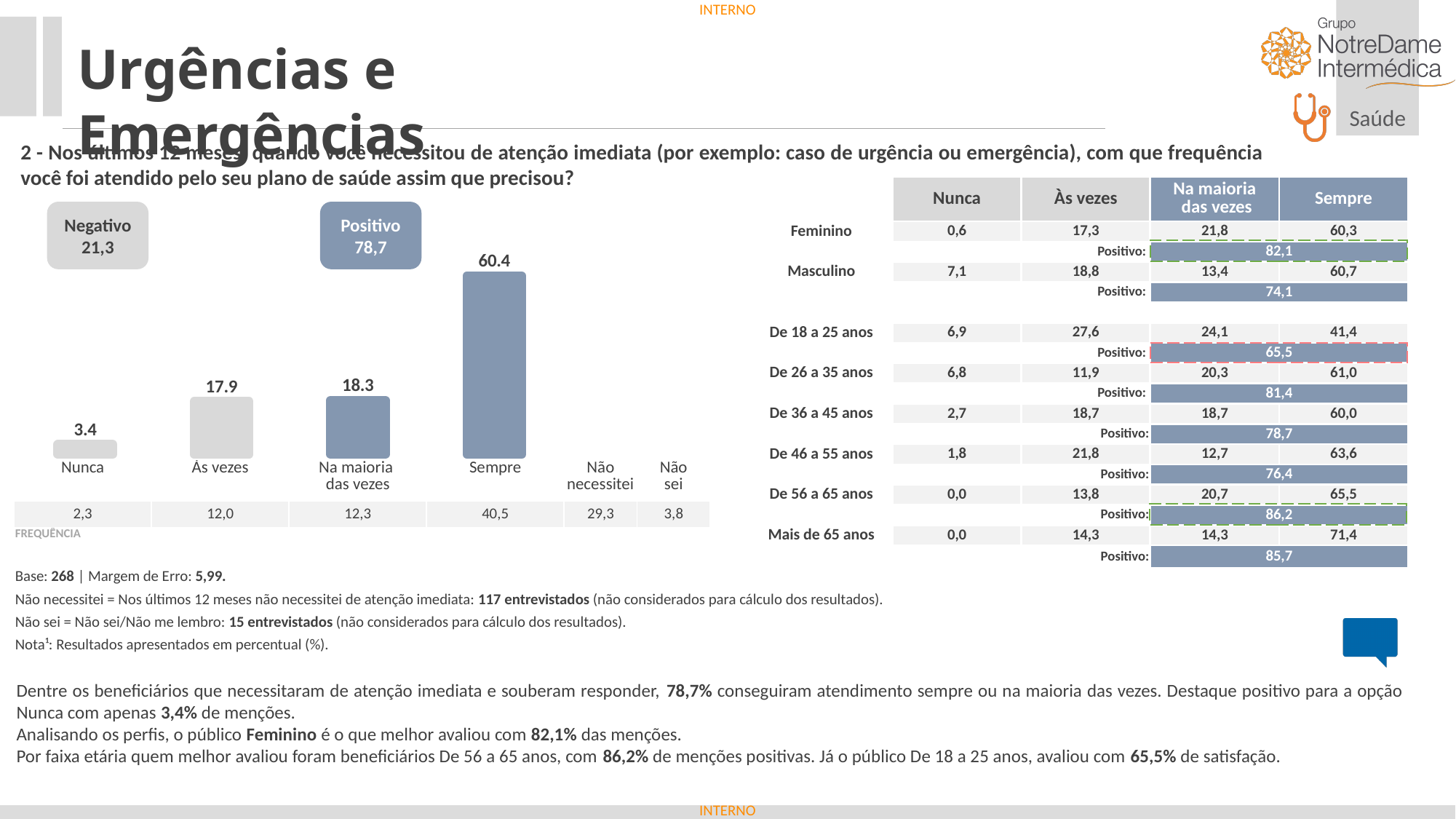
Which is larger in the bar chart, the Sempre bar or the Às vezes bar? Sempre What value is shown in the Positivo box above the bar chart? 78,7 What is the value of the Às vezes bar in the bar chart? 17.9 What kind of chart is shown on the left of the slide? Bar chart What is the difference between the Na maioria das vezes bar and the Às vezes bar in the bar chart? 0.4 What is the value of the Sempre bar in the bar chart? 60.4 What is the difference between the Sempre bar and the Nunca bar in the bar chart? 57.0 Which category has the lowest bar in the bar chart? Nunca What is the value of the Na maioria das vezes bar in the bar chart? 18.3 Which category has the highest bar in the bar chart? Sempre What value is shown in the Negativo box above the bar chart? 21,3 What is the value of the Nunca bar in the bar chart? 3.4